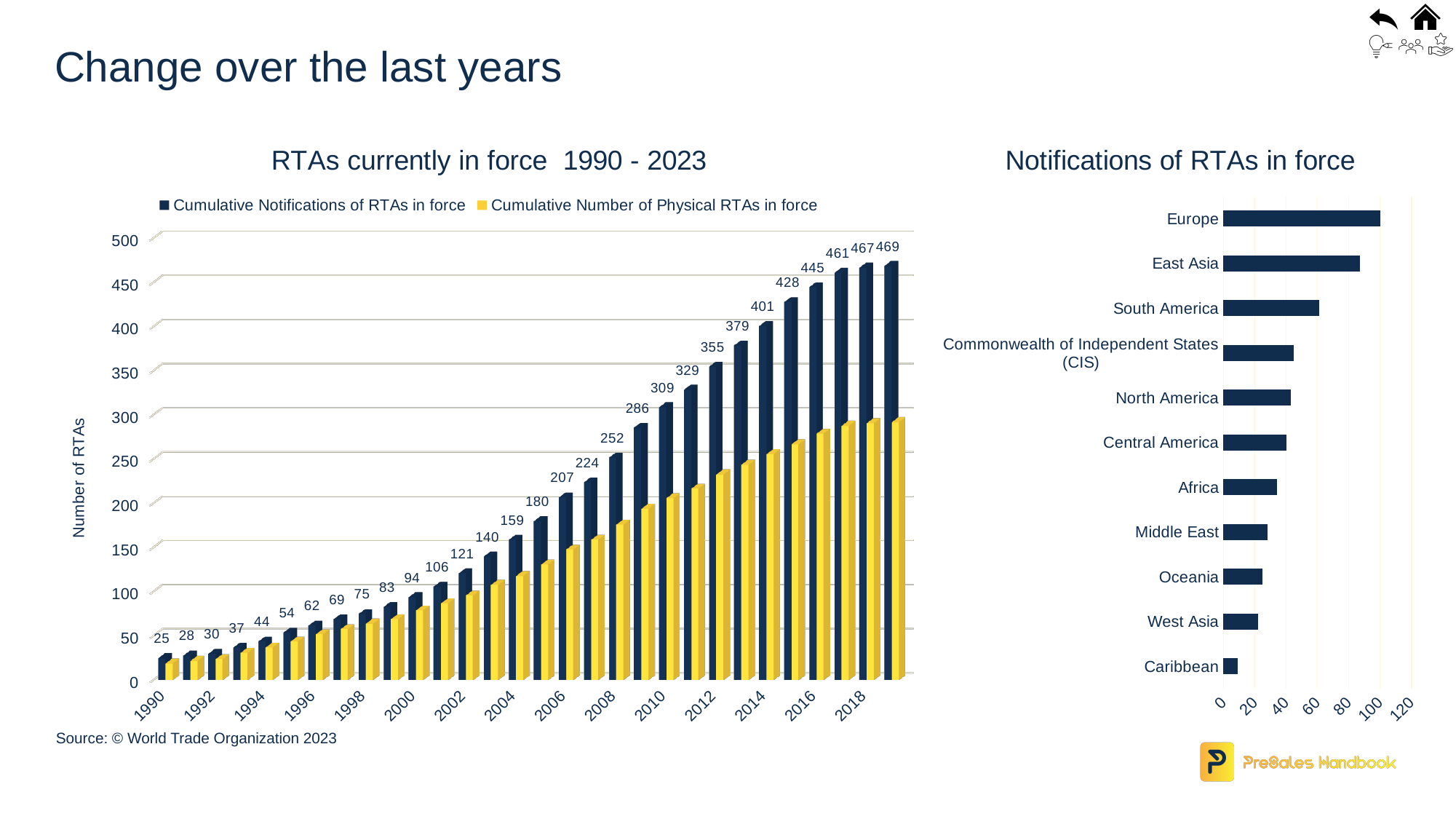
In the chart 'RTAs currently in force 1990 - 2023', do the Cumulative Notifications of RTAs in force rise or fall from 1990 to the last year shown? rise In the chart 'RTAs currently in force 1990 - 2023', what is the highest labelled value of Cumulative Notifications of RTAs in force? 469 In the chart 'Notifications of RTAs in force', which region has the lowest value? Caribbean In the chart 'RTAs currently in force 1990 - 2023', what is the value of Cumulative Notifications of RTAs in force for 2010? 309 In the chart 'RTAs currently in force 1990 - 2023', what is the value of Cumulative Notifications of RTAs in force for 1990? 25 In the chart 'RTAs currently in force 1990 - 2023', what is the value of Cumulative Notifications of RTAs in force for 2000? 94 In the chart 'RTAs currently in force 1990 - 2023', what is the difference between the Cumulative Notifications of RTAs in force for 2018 and 2016? 22 In the chart 'RTAs currently in force 1990 - 2023', how many series does the legend list? 2 In the chart 'Notifications of RTAs in force', is the value for East Asia greater or less than 80? greater In the chart 'Notifications of RTAs in force', which region has the highest value? Europe In the chart 'RTAs currently in force 1990 - 2023', is the Cumulative Number of Physical RTAs in force for 2018 greater or less than 300? less In the chart 'Notifications of RTAs in force', how many regions are shown? 11